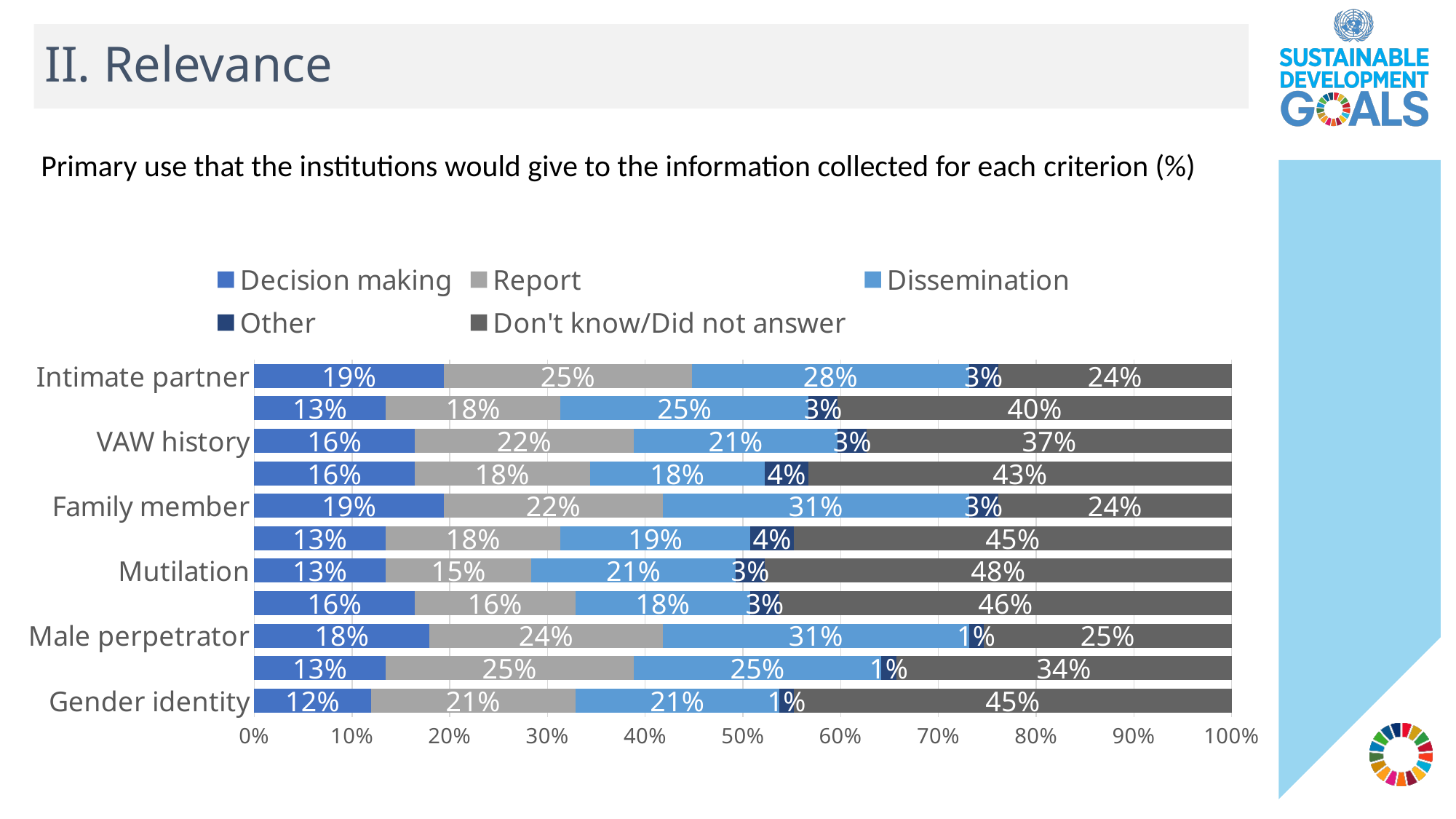
What kind of chart is shown on the slide? Stacked bar chart What percentage of institutions would use the information on Family member primarily for Dissemination? 31% Which colour represents the Report series in the legend? Grey What is the Other value for VAW history? 3% Which labelled criterion has the lowest Decision making share? Gender identity What is the Don't know/Did not answer share for Mutilation? 48% Which labelled criterion has the highest Don't know/Did not answer share? Mutilation What is the Report value for Male perpetrator? 24% Which has the larger Report value, Intimate partner or VAW history? Intimate partner How many series does the legend list? 5 What is the Decision making value for Gender identity? 12% How many percentage points higher is the Dissemination value for Family member than for Intimate partner? 3 percentage points